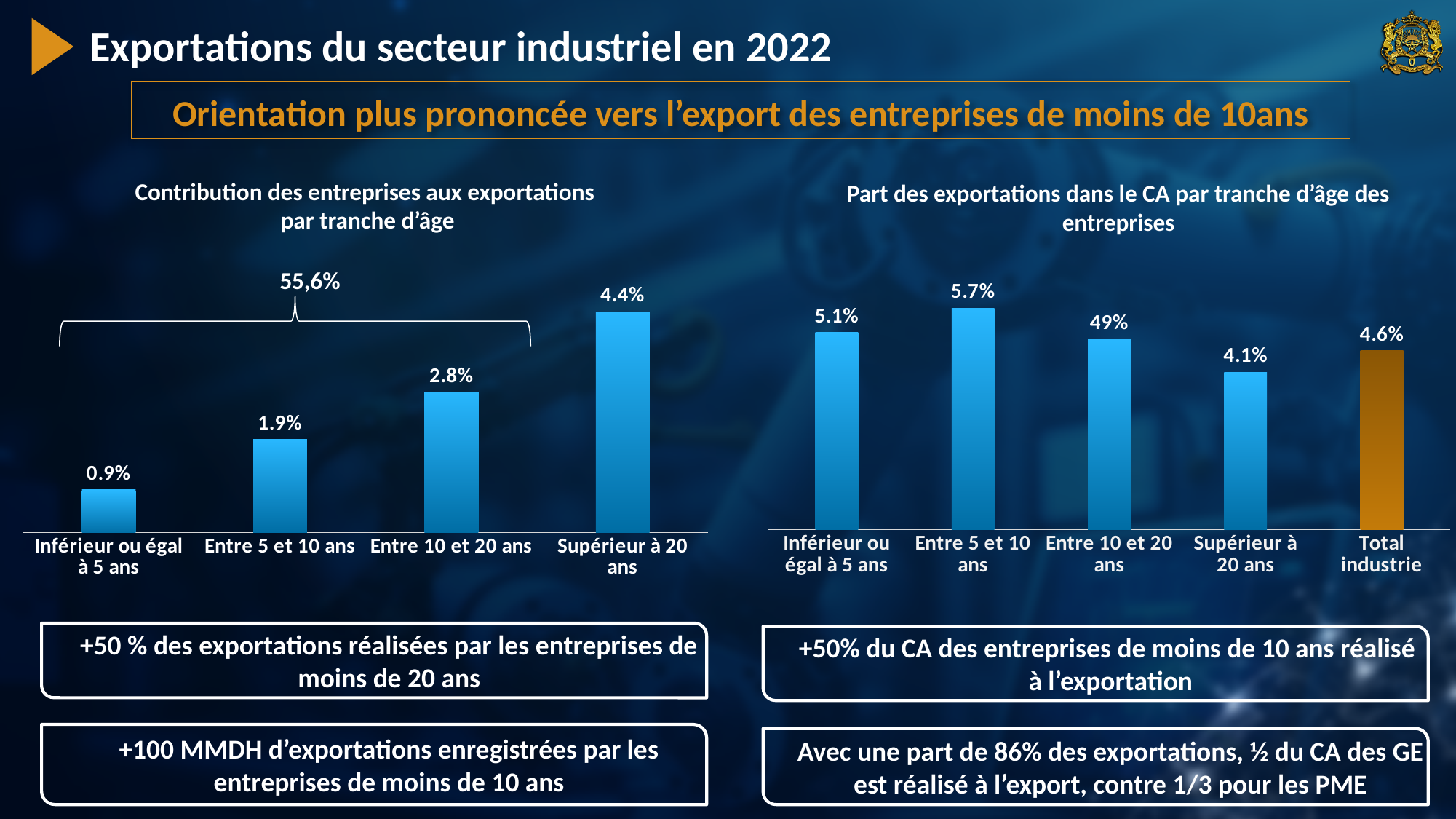
In the chart 'Part des exportations dans le CA par tranche d'âge des entreprises', how many bars are shown? 5 In the chart 'Contribution des entreprises aux exportations par tranche d'âge', which category has the highest value? Supérieur à 20 ans In the chart 'Part des exportations dans le CA par tranche d'âge des entreprises', what is the value for 'Total industrie'? 4.6% In the chart 'Contribution des entreprises aux exportations par tranche d'âge', what is the value for 'Entre 10 et 20 ans'? 2.8% In the chart 'Part des exportations dans le CA par tranche d'âge des entreprises', which is larger: 'Inférieur ou égal à 5 ans' or 'Supérieur à 20 ans'? Inférieur ou égal à 5 ans In the chart 'Part des exportations dans le CA par tranche d'âge des entreprises', what is the value for 'Entre 5 et 10 ans'? 5.7% In the chart 'Contribution des entreprises aux exportations par tranche d'âge', how many categories are shown? 4 In the chart 'Contribution des entreprises aux exportations par tranche d'âge', what is the value for 'Inférieur ou égal à 5 ans'? 0.9% In the chart 'Contribution des entreprises aux exportations par tranche d'âge', what is the difference between 'Supérieur à 20 ans' and 'Inférieur ou égal à 5 ans'? 3.5% In the chart 'Contribution des entreprises aux exportations par tranche d'âge', do the values rise or fall from left to right? rise What type of chart is 'Part des exportations dans le CA par tranche d'âge des entreprises'? bar chart In the chart 'Contribution des entreprises aux exportations par tranche d'âge', which category has the lowest value? Inférieur ou égal à 5 ans